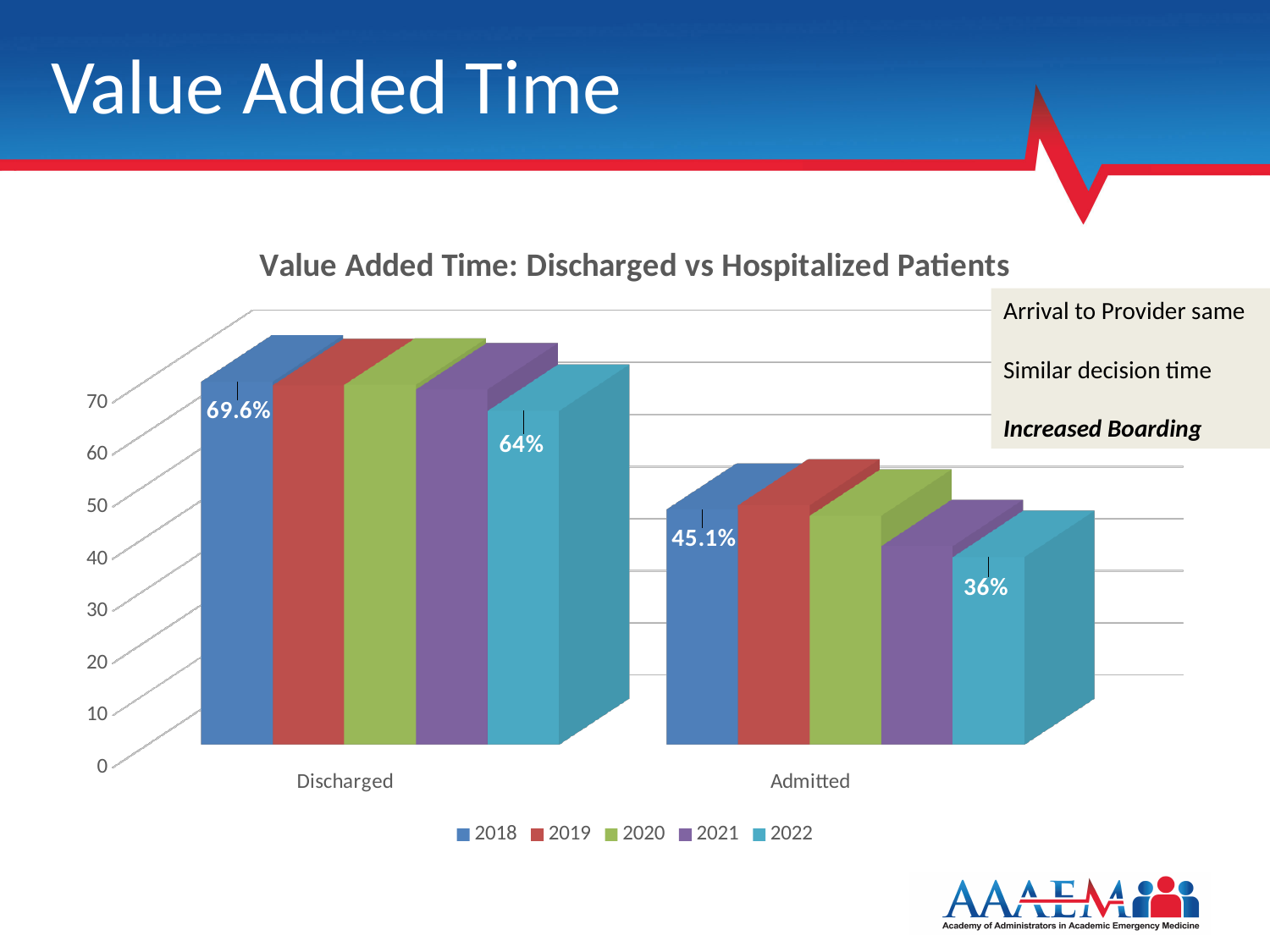
What kind of chart is shown on the slide? Bar chart What is the title of the chart? Value Added Time: Discharged vs Hospitalized Patients What is the value for 2018 in the Admitted category? 45.1% What is the value for 2022 in the Admitted category? 36% What is the difference between the 2018 and 2022 values for Discharged patients? 5.6 percentage points What is the value for 2022 in the Discharged category? 64% What is the difference between the 2018 and 2022 values for Admitted patients? 9.1 percentage points What is the value for 2018 in the Discharged category? 69.6% Which is larger, the 2018 value for Discharged or the 2018 value for Admitted? Discharged How many categories are shown on the x axis? 2 Is the 2019 value for Admitted greater or less than 60? less How many series does the legend list? 5